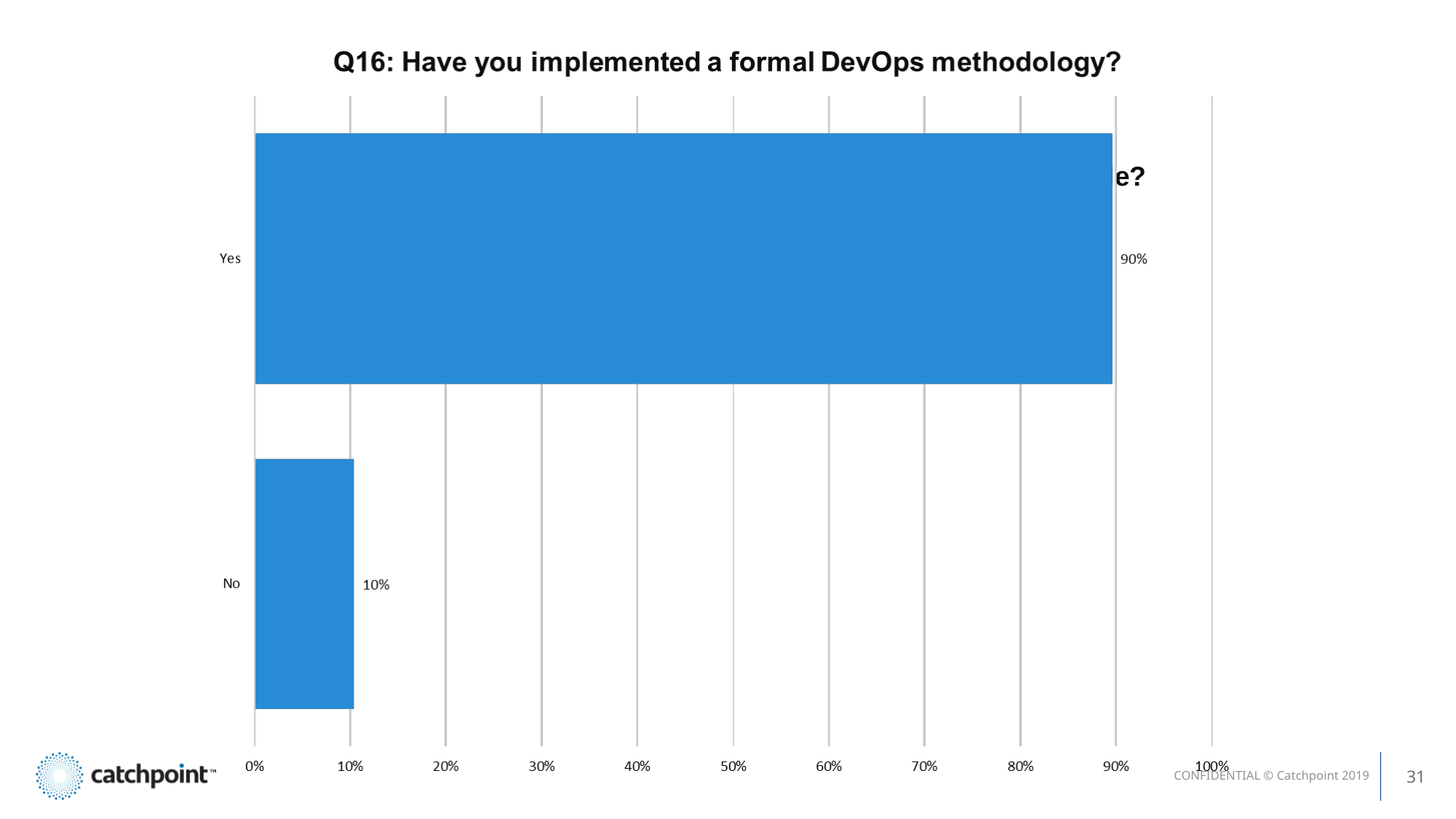
How many response categories are shown in the chart? 2 What is the title of the chart? Q16: Have you implemented a formal DevOps methodology? What is the difference in percentage points between the "Yes" and "No" responses? 80 percentage points What is the maximum value shown on the x axis? 100% Which response category has the highest value? Yes Is the value for "No" greater or less than 20%? less What percentage of respondents answered "No"? 10% Is the value for "Yes" greater or less than 50%? greater What percentage of respondents answered "Yes" to having implemented a formal DevOps methodology? 90% Which response category has the lowest value? No Which is larger, the value for "Yes" or the value for "No"? Yes What type of chart is shown on the slide? Bar chart